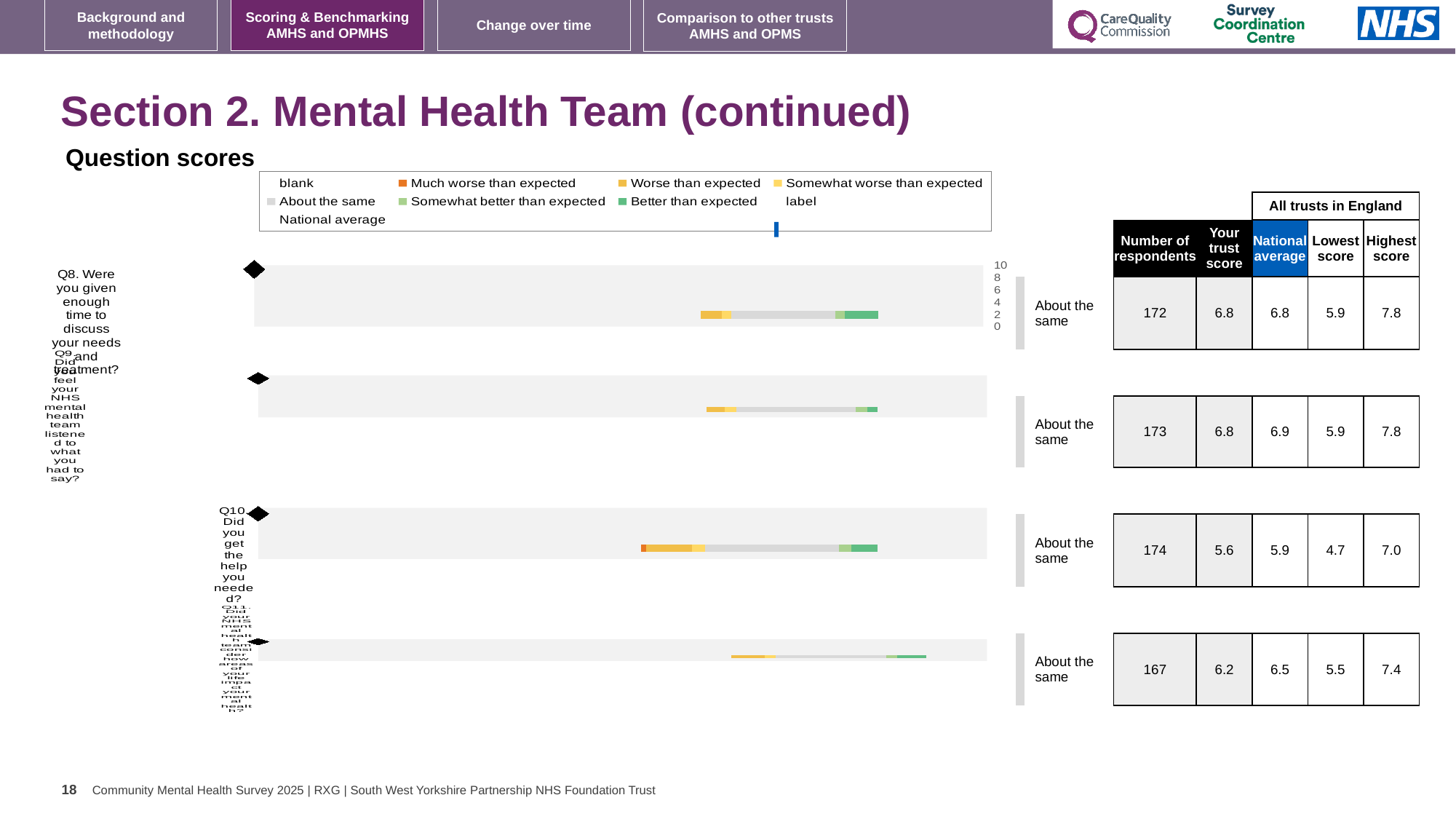
In the table beside the Q8 chart, what is the number of respondents? 172 How many question score bar charts are shown on the slide? 4 In the table beside the Q8 chart, what is 'Your trust score'? 6.8 What kind of chart is used to show the question scores on this slide? bar chart In the table beside the bottom (Q11) chart, what is the highest score among all trusts in England? 7.4 What category label is shown to the right of the Q8 bar chart? About the same In the table beside the Q10 chart, what is the lowest score among all trusts in England? 4.7 In the legend above the charts, which colour represents 'Much worse than expected'? orange In the legend above the charts, which colour represents 'Better than expected'? green What is the difference between the highest score and the lowest score for Q9 in the table? 1.9 Which question row has the highest number of respondents in the table: Q8, Q9, Q10 or Q11? Q10 In the table beside the Q10 chart ('Did you get the help you needed?'), what is the national average? 5.9